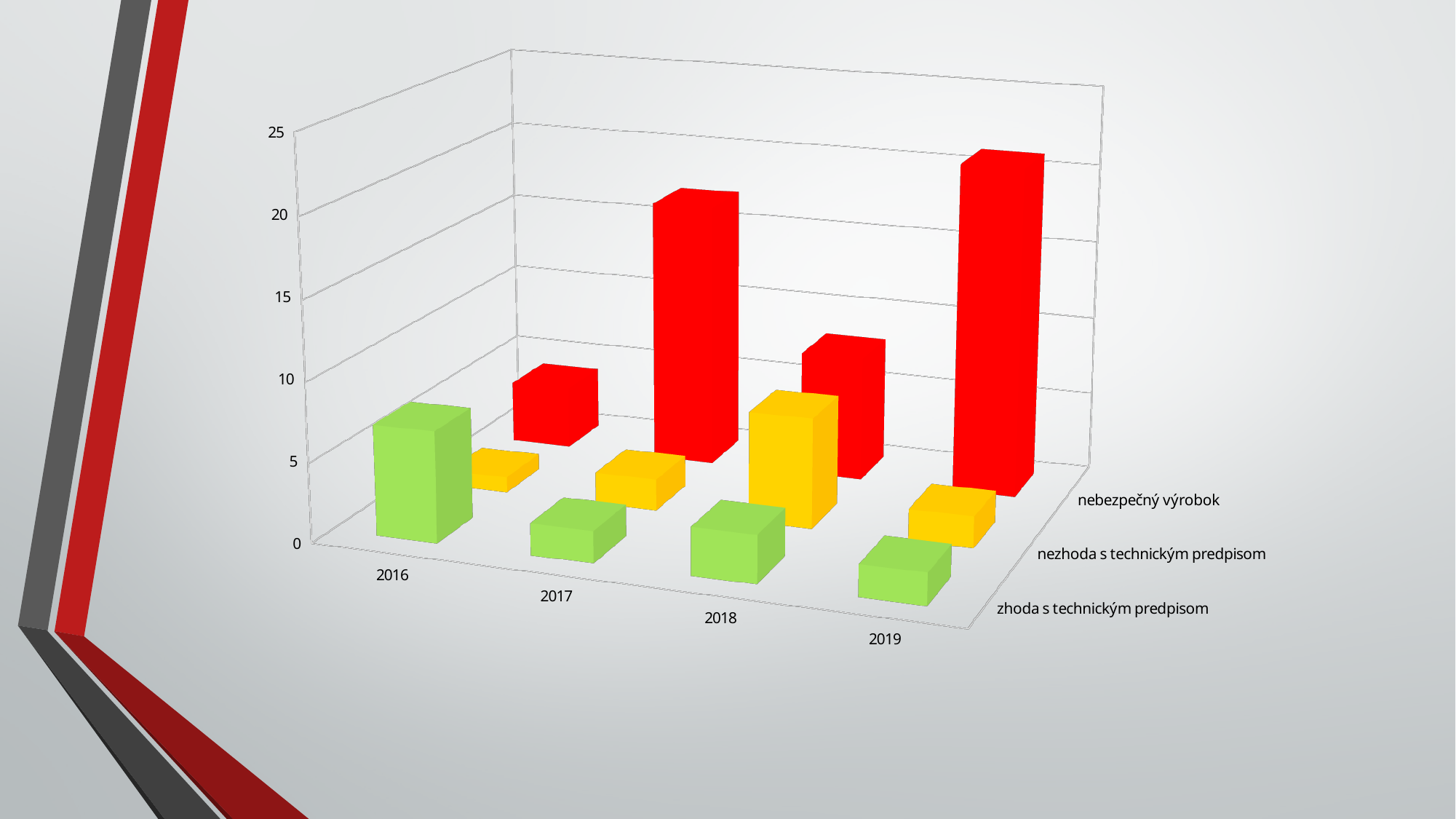
What colour are the bars for the nebezpečný výrobok series? red How many series does the chart show? 3 Is the value for zhoda s technickým predpisom in 2017 greater or less than 5? less Which year has the highest value for zhoda s technickým predpisom? 2016 Is the value for nebezpečný výrobok in 2019 greater or less than 15? greater Which year has the lowest value for nebezpečný výrobok? 2016 How many years are shown on the category axis? 4 Which year has the highest value for nezhoda s technickým predpisom? 2018 Which year has the highest value for nebezpečný výrobok? 2019 What kind of chart is shown on the slide? bar chart Is the value for nebezpečný výrobok in 2016 greater or less than 10? less Which is larger: nebezpečný výrobok in 2017 or nebezpečný výrobok in 2018? 2017